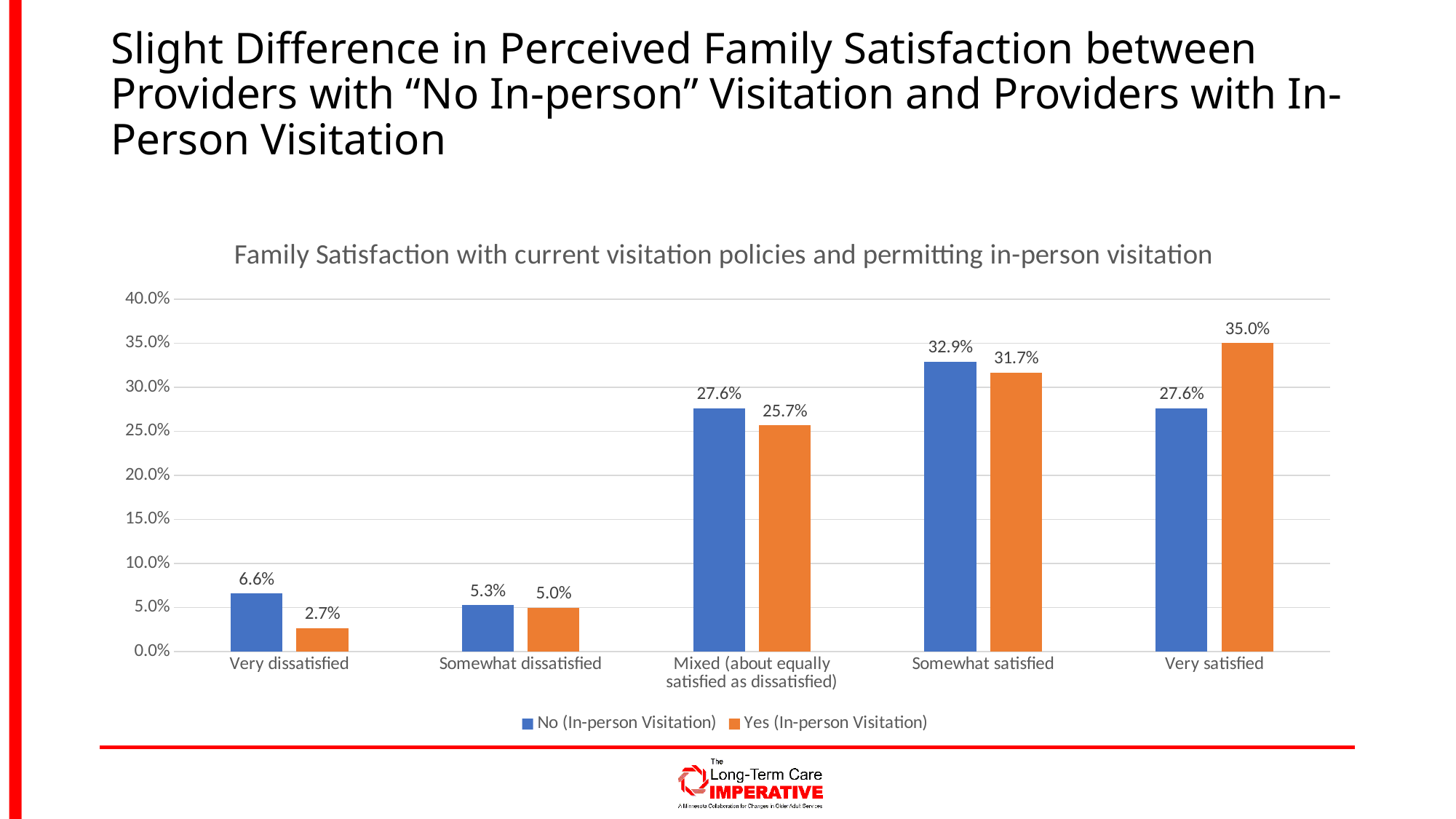
What is the value for "Mixed (about equally satisfied as dissatisfied)" in the "Yes (In-person Visitation)" series? 25.7% Which category has the lowest value in the "Yes (In-person Visitation)" series? Very dissatisfied What is the difference between the "No (In-person Visitation)" and "Yes (In-person Visitation)" values for "Very dissatisfied"? 3.9% What is the value for "Very satisfied" in the "Yes (In-person Visitation)" series? 35.0% What is the difference between the "No (In-person Visitation)" and "Yes (In-person Visitation)" values for "Very satisfied"? 7.4% How many series does the legend list? 2 For "Somewhat satisfied", which series has the larger value: "No (In-person Visitation)" or "Yes (In-person Visitation)"? No (In-person Visitation) What kind of chart is shown on the slide? Bar chart Is the value for "Somewhat dissatisfied" in the "No (In-person Visitation)" series greater or less than 10.0%? less Which category has the highest value in the "No (In-person Visitation)" series? Somewhat satisfied What is the value for "Very dissatisfied" in the "No (In-person Visitation)" series? 6.6% How many categories are shown on the x axis? 5